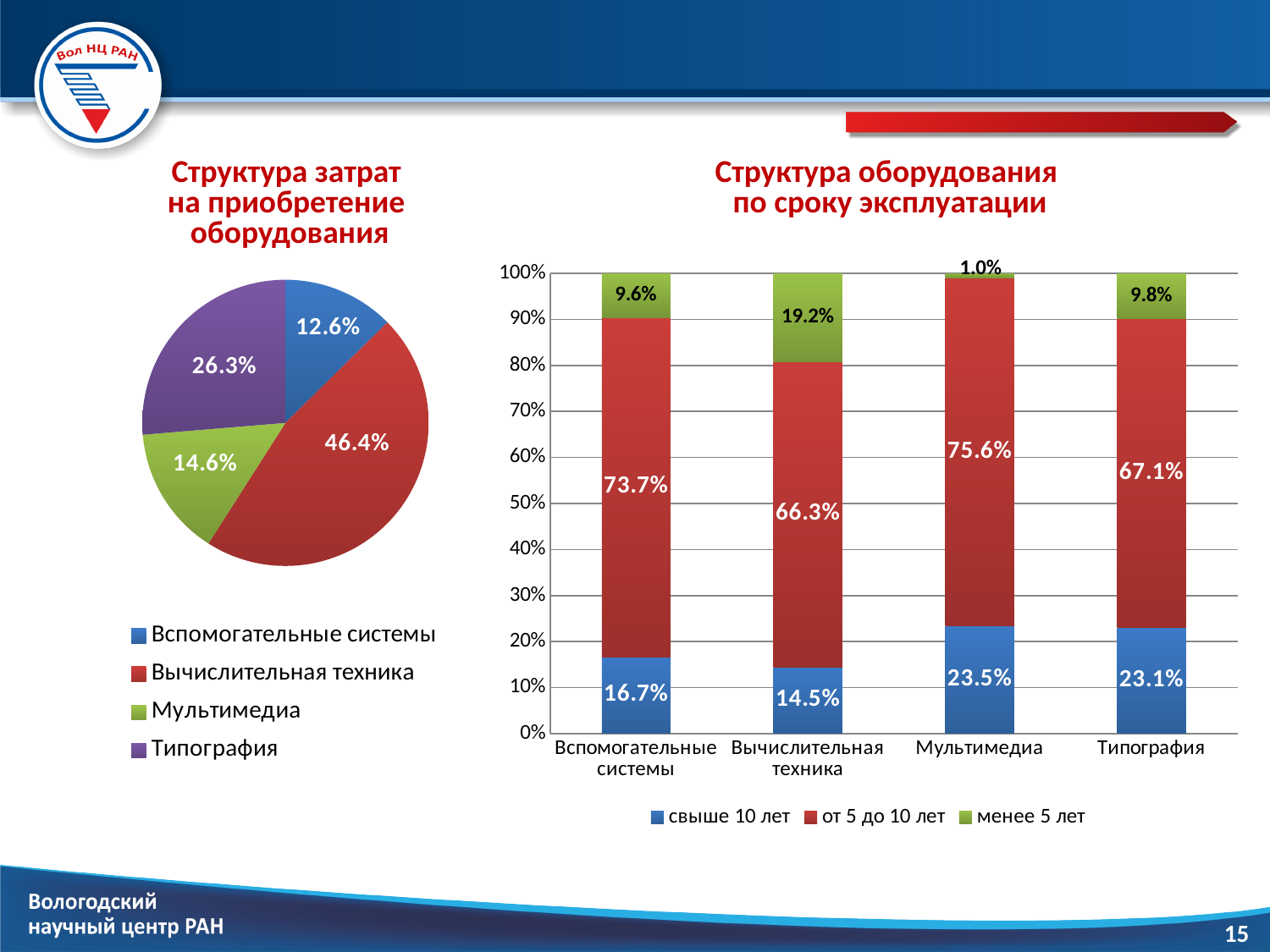
In the pie chart 'Структура затрат на приобретение оборудования', what share does 'Вычислительная техника' have? 46.4% In the pie chart 'Структура затрат на приобретение оборудования', which category has the smallest share? Вспомогательные системы In the bar chart 'Структура оборудования по сроку эксплуатации', what is the value of 'от 5 до 10 лет' for 'Мультимедиа'? 75.6% In the bar chart 'Структура оборудования по сроку эксплуатации', which category has the highest value for 'свыше 10 лет'? Мультимедиа In the bar chart 'Структура оборудования по сроку эксплуатации', which is larger: 'от 5 до 10 лет' for 'Вспомогательные системы' or for 'Типография'? Вспомогательные системы What type of chart is 'Структура оборудования по сроку эксплуатации'? Stacked bar chart In the bar chart 'Структура оборудования по сроку эксплуатации', what is the difference between 'свыше 10 лет' for 'Мультимедиа' and for 'Вычислительная техника'? 9.0% How many series does the legend of the bar chart 'Структура оборудования по сроку эксплуатации' list? 3 In the bar chart 'Структура оборудования по сроку эксплуатации', what is the value of 'менее 5 лет' for 'Вычислительная техника'? 19.2% In the bar chart 'Структура оборудования по сроку эксплуатации', which category has the lowest value for 'менее 5 лет'? Мультимедиа How many slices does the pie chart 'Структура затрат на приобретение оборудования' have? 4 In the pie chart 'Структура затрат на приобретение оборудования', what is the difference between the shares of 'Типография' and 'Мультимедиа'? 11.7%